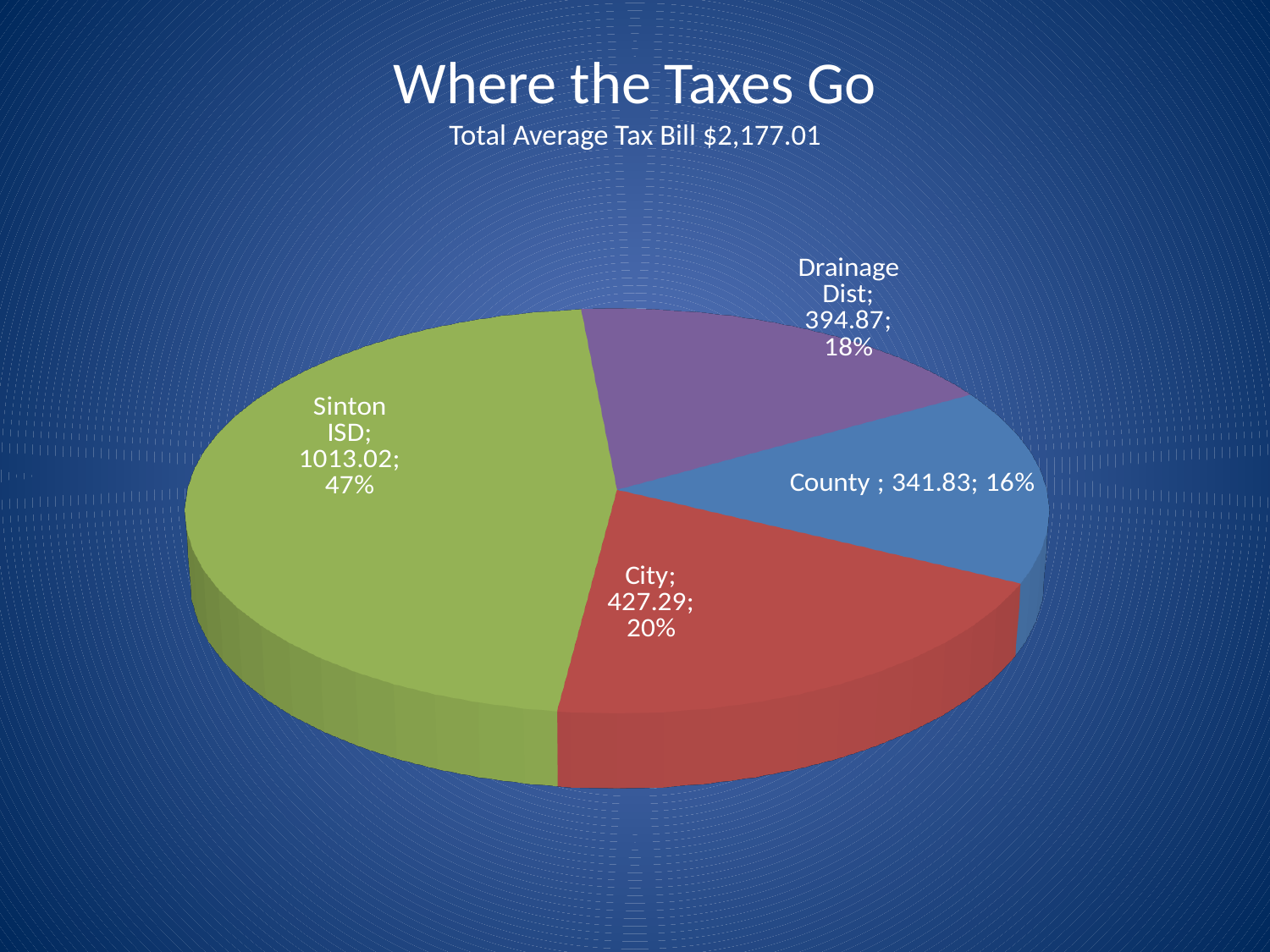
Which is larger, the value for Drainage Dist or the value for County? Drainage Dist What is the value for City? 427.29 What is the difference between the values for City and County? 85.46 What kind of chart is shown on the slide? pie chart What share of the pie does City represent? 20% Which category has the largest slice? Sinton ISD Which category has the smallest slice? County What is the value for County? 341.83 What is the value for Drainage Dist? 394.87 What share of the pie does Drainage Dist represent? 18% How many slices does the pie chart have? 4 What is the value for Sinton ISD? 1013.02